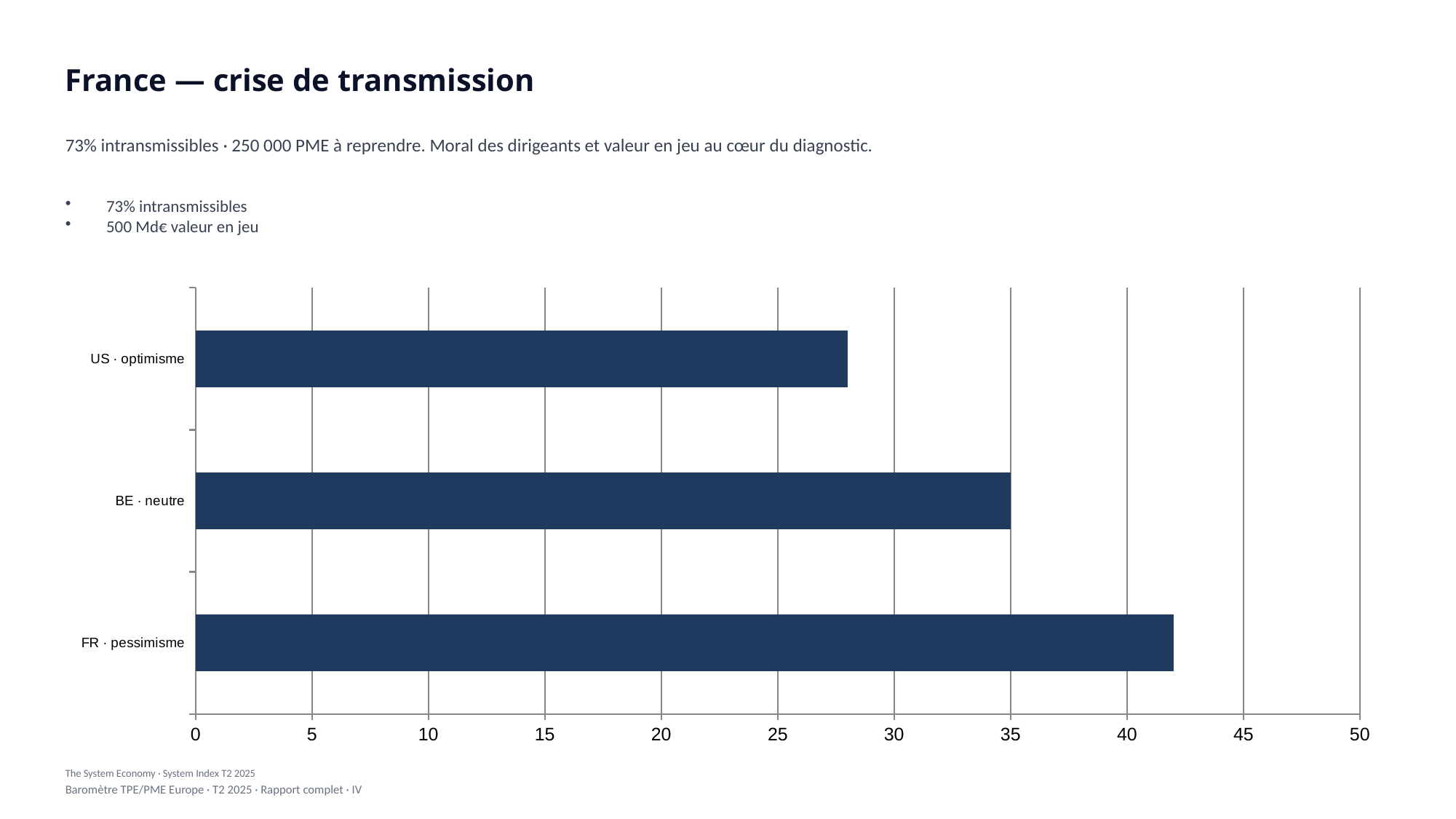
Is the value for FR · pessimisme greater or less than 40? greater Is the value for US · optimisme greater or less than 30? less What is the maximum value shown on the horizontal axis of the chart? 50 How many categories are plotted in the bar chart? 3 Which category has the highest value in the bar chart? FR · pessimisme Is the value for FR · pessimisme greater or less than 45? less What kind of chart is shown on the slide? bar chart What is the value for BE · neutre? 35 Which is larger, the value for BE · neutre or the value for US · optimisme? BE · neutre Which category has the lowest value in the bar chart? US · optimisme Which is larger, the value for FR · pessimisme or the value for BE · neutre? FR · pessimisme